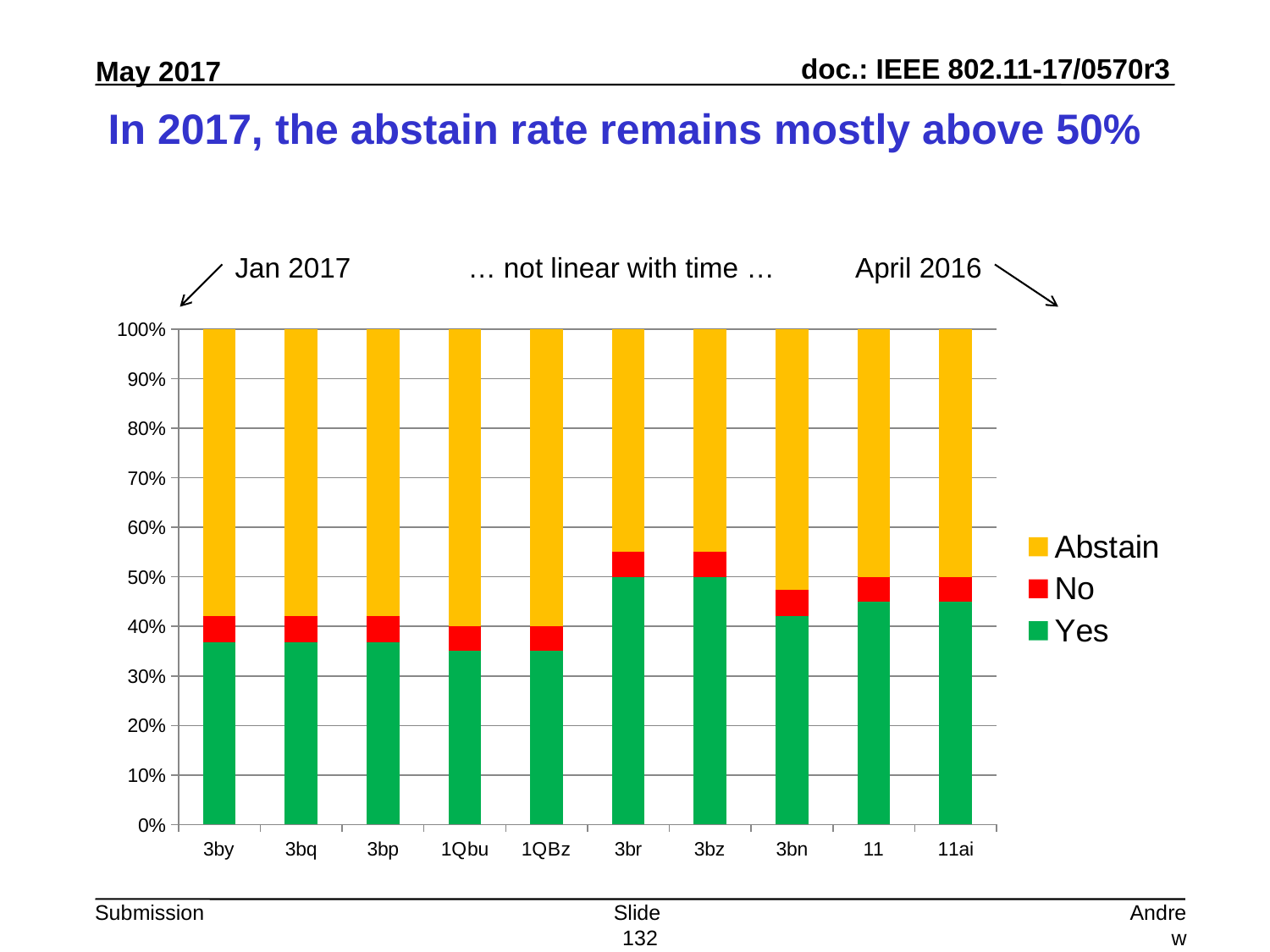
How many series does the chart's legend list? 3 Is the Abstain share for 3br greater or less than 50%? less How many categories are shown along the x axis of the chart? 10 Is the Abstain share for 3by greater or less than 50%? greater What kind of chart is shown on the slide? bar chart What is the total height of the stacked bar for 3bq? 100% Which series is shown in green in the chart? Yes Which has a larger Yes value, 3br or 3by? 3br Is the Yes value for 3by greater or less than 40%? less What is the title of the slide containing the chart? In 2017, the abstain rate remains mostly above 50%